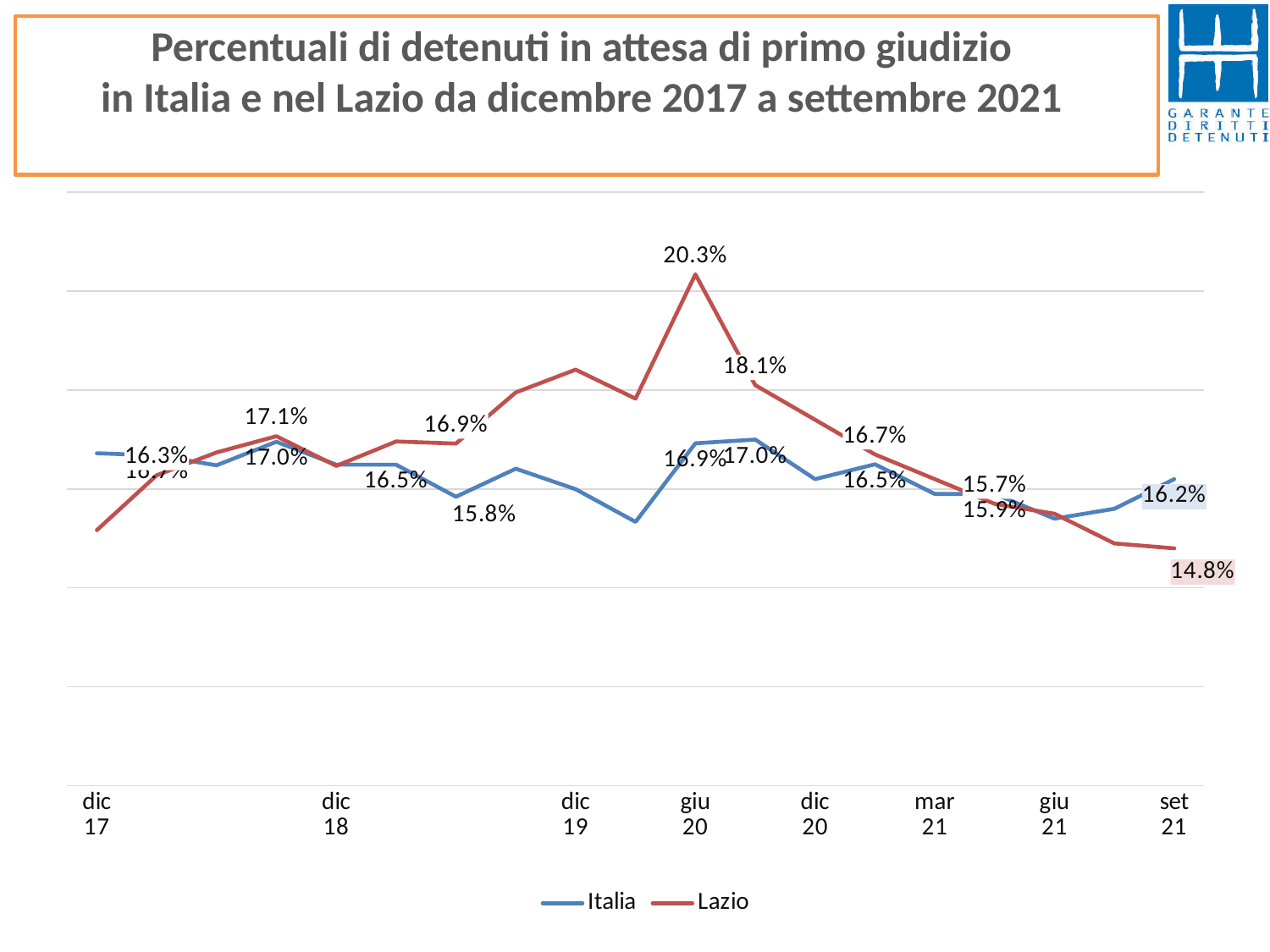
What is the difference between the Italia and Lazio values at set 21? 1.4 percentage points What are the two series named in the legend? Italia and Lazio What is the value for Italia at set 21? 16.2% What kind of chart is shown on the slide? line chart At which x-axis label does the Lazio line reach its highest value? giu 20 What is the value for Lazio at set 21? 14.8% What is the value for Lazio at giu 20? 20.3% At set 21, which series has the higher value, Italia or Lazio? Italia Does the Lazio line rise or fall from giu 20 to set 21? fall How many series does the legend list? 2 At giu 20, which series has the higher value, Italia or Lazio? Lazio What is the highest value labelled on the chart? 20.3%